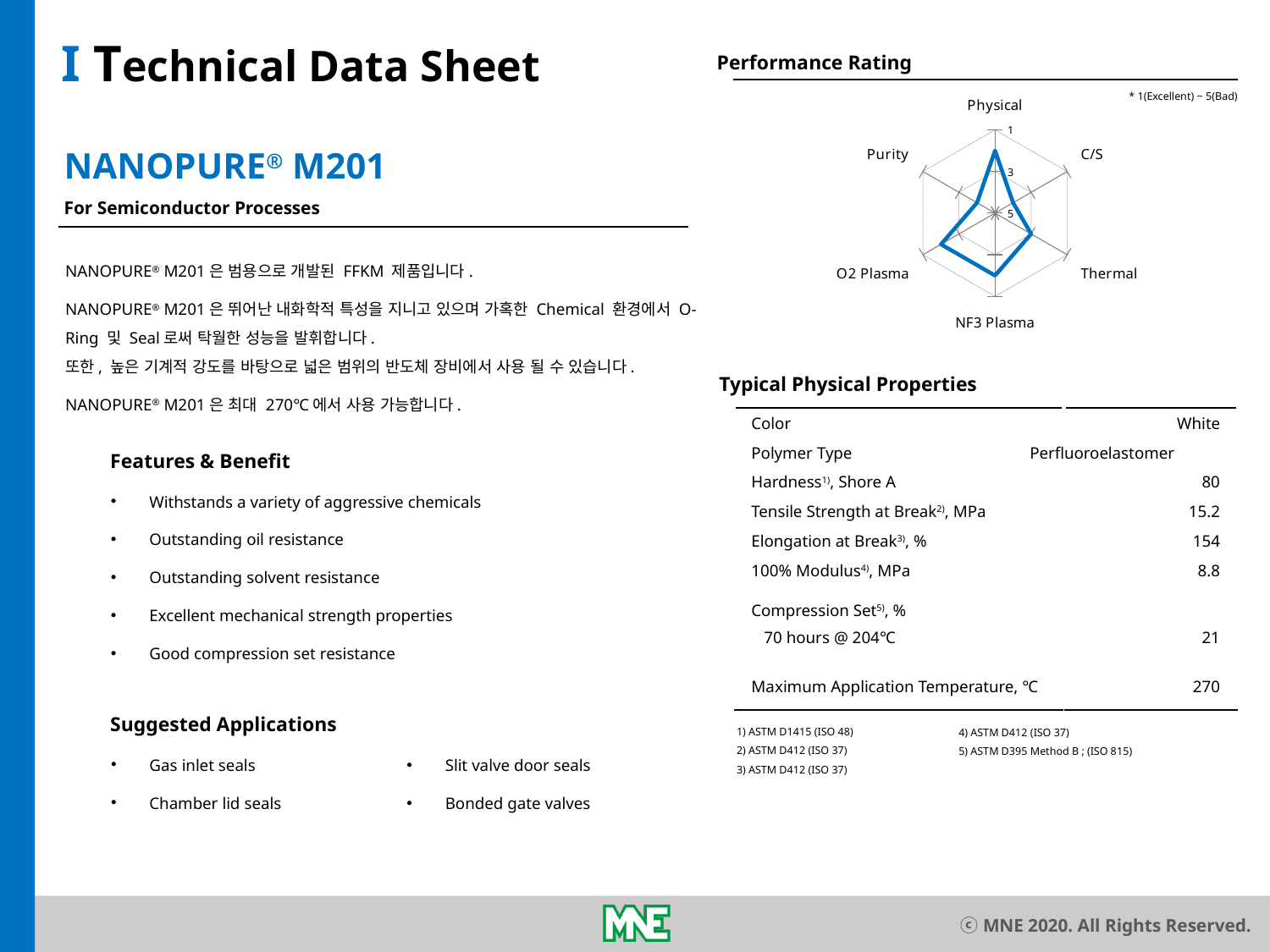
In the Performance Rating chart, is the rating for NF3 Plasma greater or less than 3? less In the Performance Rating chart, which has the better (lower) rating, Physical or C/S? Physical What kind of chart is shown under "Performance Rating"? Radar chart In the Performance Rating chart, is the rating for Physical greater or less than 3? less In the Performance Rating chart, is the rating for O2 Plasma greater or less than 3? less How many categories (axes) does the Performance Rating radar chart have? 6 In the Performance Rating chart, which category has the worst (highest) rating? Purity and C/S According to the note on the Performance Rating chart, what rating scale is used? 1(Excellent) ~ 5(Bad) In the Performance Rating chart, which has the better (lower) rating, O2 Plasma or Purity? O2 Plasma Which category label appears at the top of the Performance Rating radar chart? Physical What is the title of the chart on the slide? Performance Rating